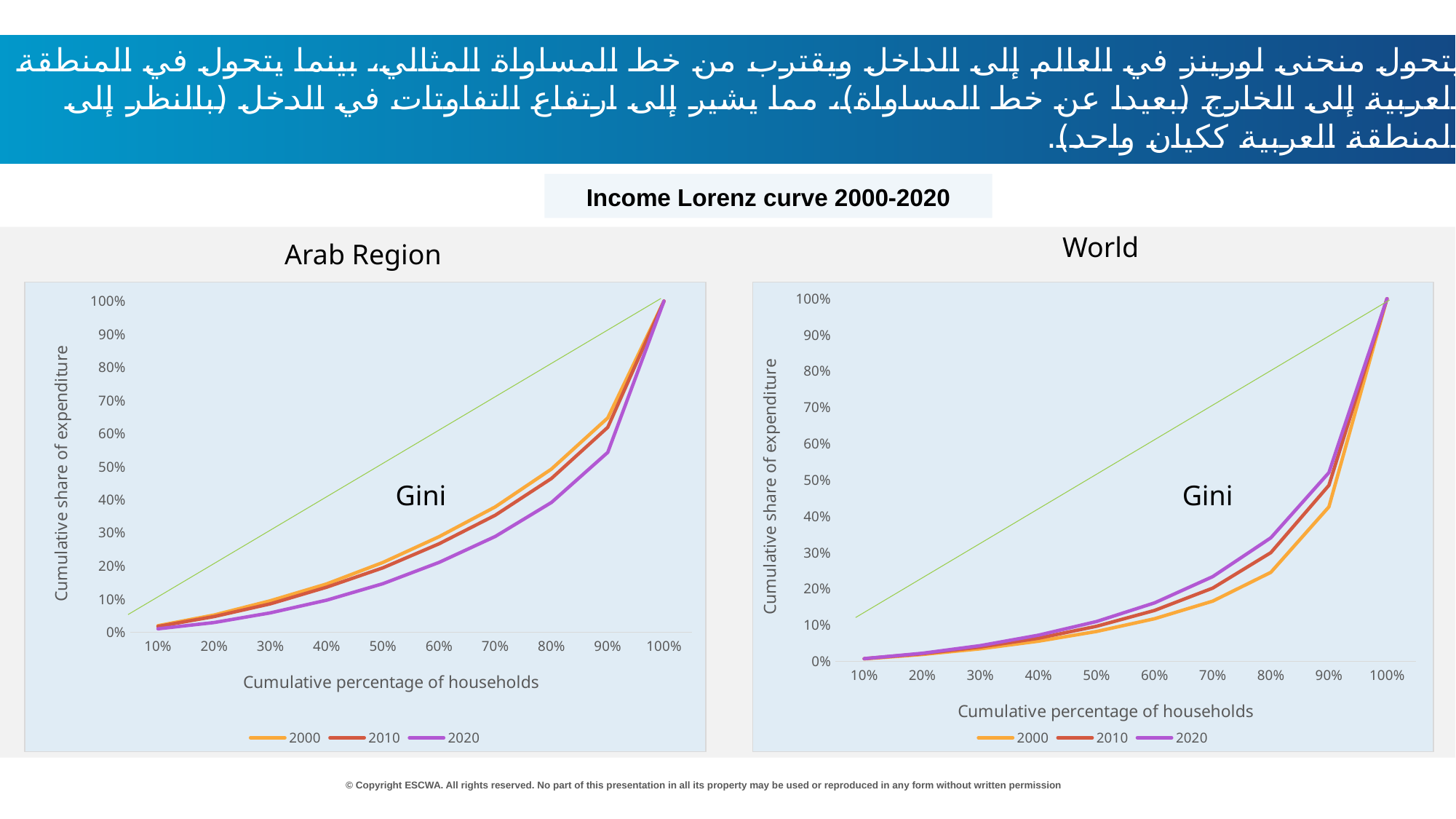
In the World chart, is the value of the 2000 series at 90% of households greater or less than 50%? less In the Arab Region chart, what is the value of the 2020 series at 100% of households? 100% In the Arab Region chart, at 90% of households, which series has the larger value: 2000 or 2020? 2000 In the Arab Region chart, do the values of the 2020 series rise or fall as the cumulative percentage of households increases? rise In the World chart, at 80% of households, which series has the larger value: 2000 or 2020? 2020 In the Arab Region chart, is the value of the 2020 series at 90% of households greater or less than 60%? less What is the title of the y axis on the World chart? Cumulative share of expenditure In the World chart, is the value of the 2020 series at 80% of households greater or less than 30%? greater How many series does the legend of the World chart list? 3 What kind of chart is the Arab Region chart? line chart How many points are shown on the x axis of the Arab Region chart? 10